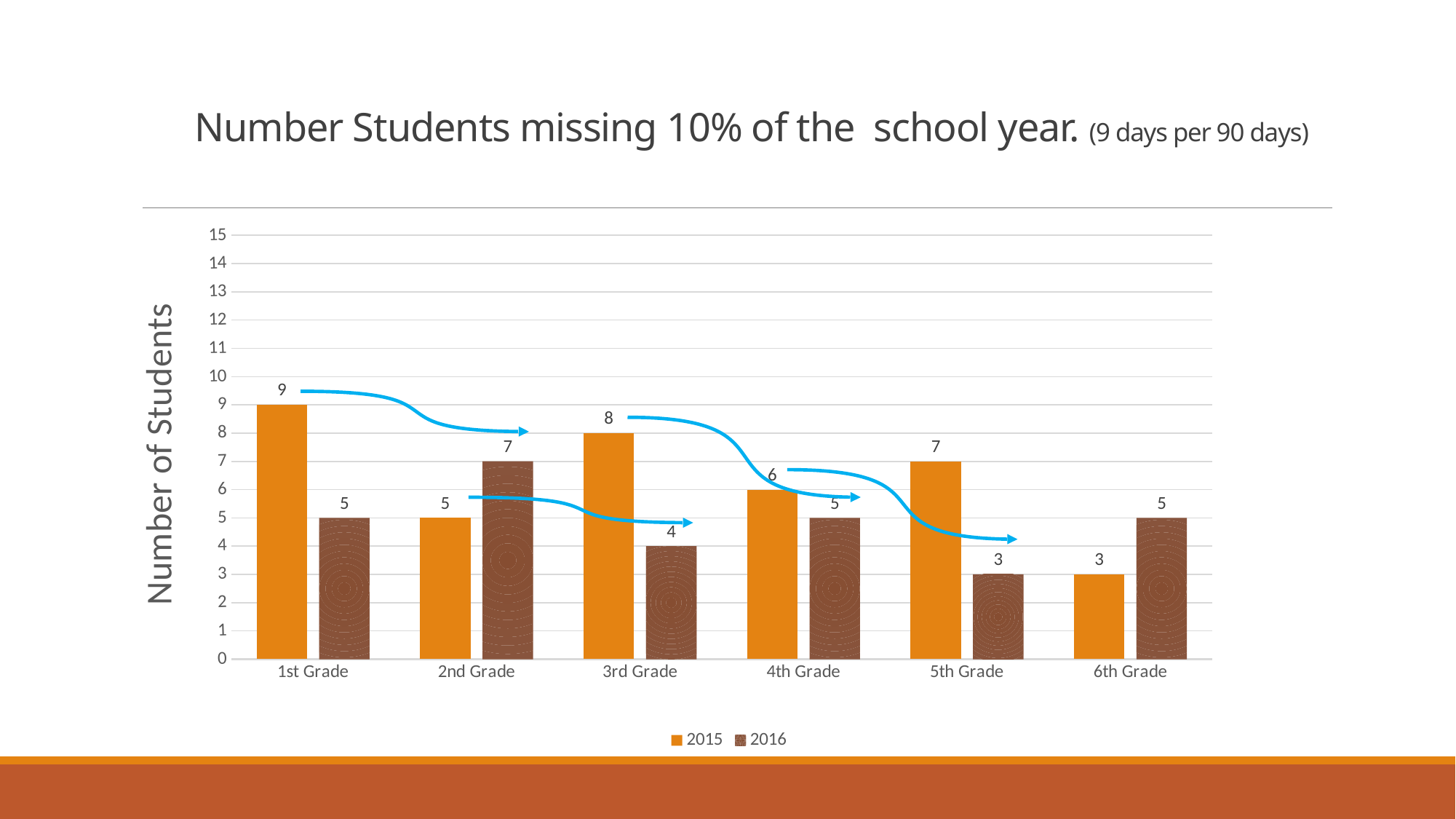
What is the value for 2nd Grade in the 2016 series? 7 Which grade has the highest value in the 2016 series? 2nd Grade What is the value for 1st Grade in the 2015 series? 9 How many grade categories are shown on the x axis? 6 What is the label on the vertical axis? Number of Students Which grade has the lowest value in the 2015 series? 6th Grade What is the value for 5th Grade in the 2016 series? 3 What is the difference between the 2015 and 2016 values for 3rd Grade? 4 What kind of chart is shown on the slide? Bar chart Which is larger for 6th Grade, the 2015 value or the 2016 value? 2016 Which grade has the highest value in the 2015 series? 1st Grade How many series does the legend list? 2